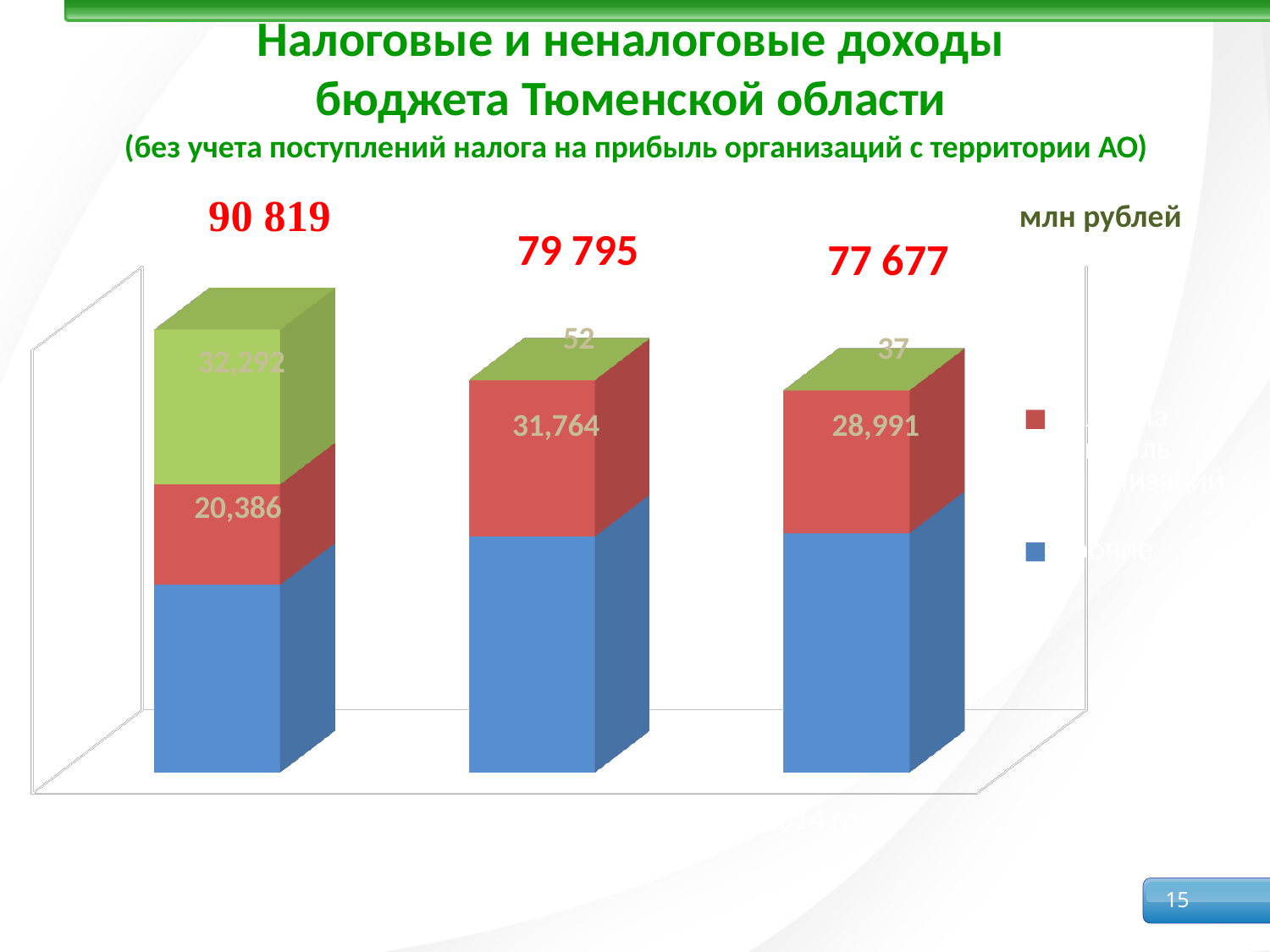
Do the bar totals rise or fall from left to right? fall Which bar has the highest total value? the leftmost bar What is the value of the red segment in the leftmost bar? 20,386 How many stacked bars are plotted in the chart? 3 What is the value of the green segment in the leftmost bar? 32,292 What is the difference between the totals of the leftmost bar and the middle bar? 11 024 What kind of chart is shown on the slide? stacked bar chart What total value is printed above the middle bar? 79 795 What total value is printed above the rightmost bar? 77 677 Which bar has the lowest total value? the rightmost bar What is the value of the red segment in the middle bar? 31,764 What total value is printed above the leftmost bar? 90 819